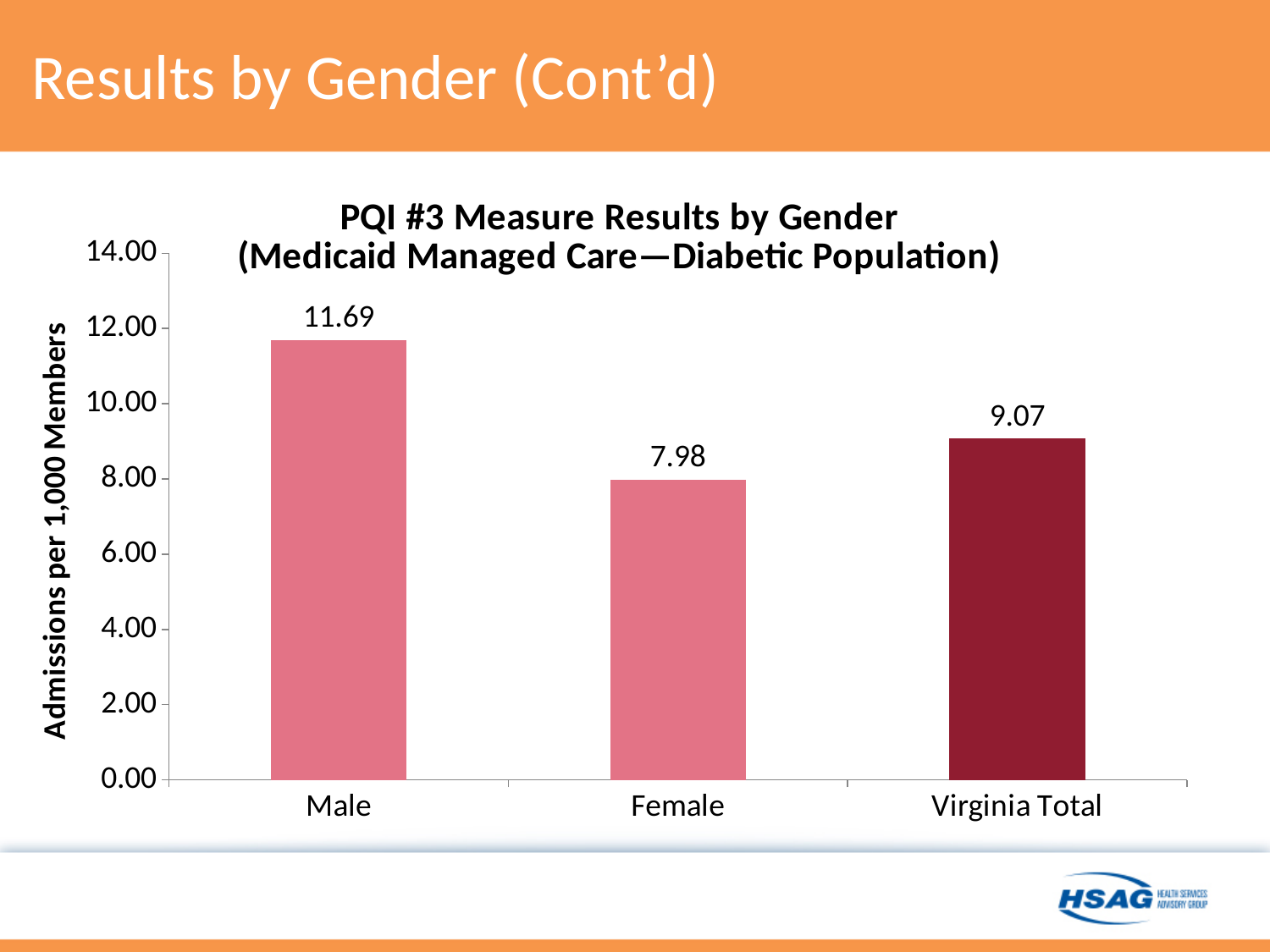
How many categories are shown on the x axis? 3 Is the value for Male greater or less than 10.00? greater What is the y-axis label of the chart? Admissions per 1,000 Members What is the value for Male? 11.69 What kind of chart is this? bar chart Which category has the highest value? Male Which is larger, the value for Female or the value for Virginia Total? Virginia Total What is the difference between the Male and Female values? 3.71 Which category has the lowest value? Female What is the value for Female? 7.98 What is the difference between the Virginia Total and Female values? 1.09 What is the value for Virginia Total? 9.07